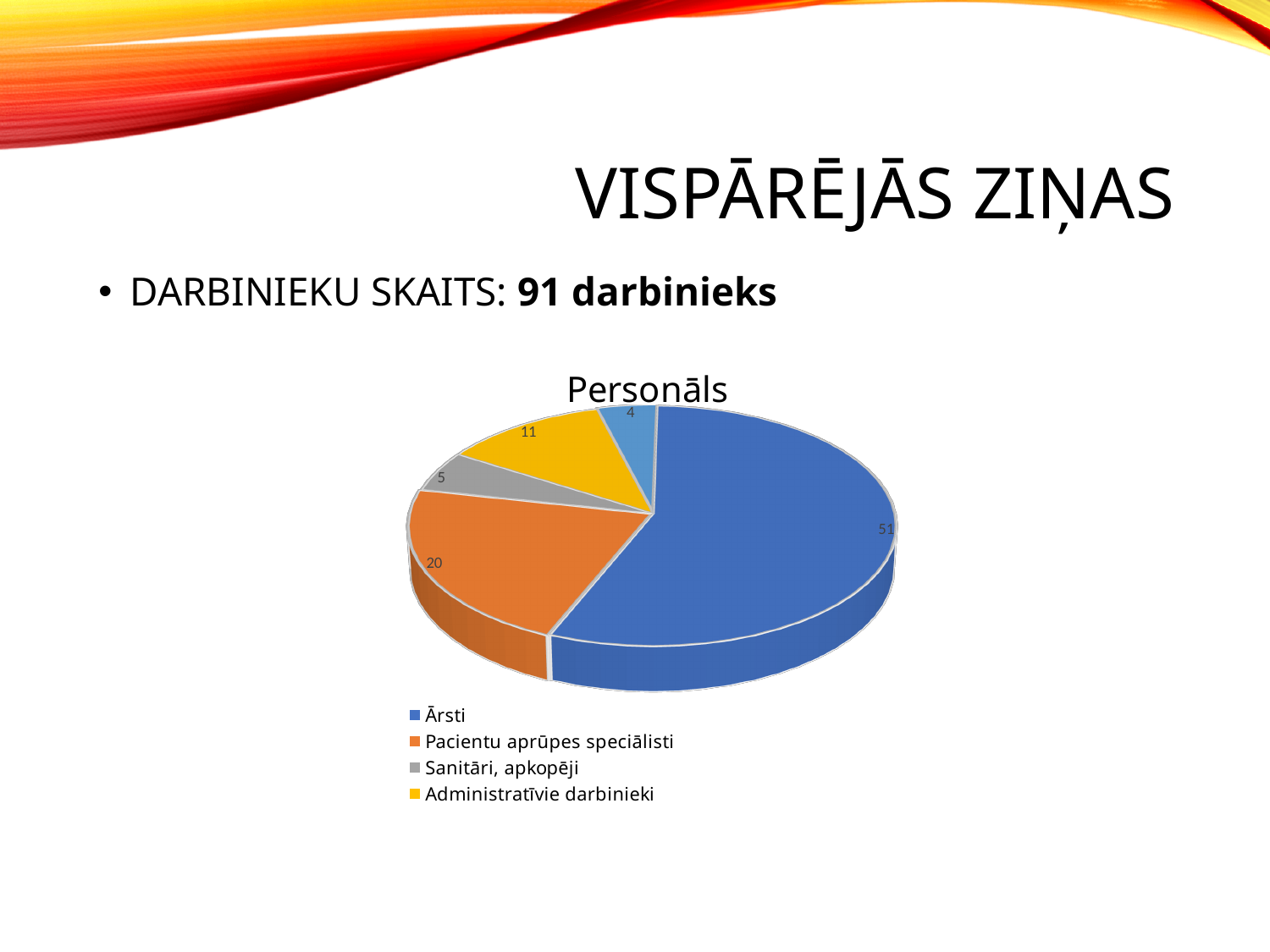
What is the title of the chart on the slide? Personāls How many entries does the legend of the Personāls chart list? 4 In the Personāls pie chart, what is the value for Ārsti? 51 In the Personāls pie chart, which is larger: Administratīvie darbinieki or Sanitāri, apkopēji? Administratīvie darbinieki Which category has the largest slice in the Personāls pie chart? Ārsti How many slices does the Personāls pie chart have? 5 In the Personāls pie chart, what is the difference between the values for Ārsti and Pacientu aprūpes speciālisti? 31 Of the categories listed in the legend of the Personāls pie chart, which has the smallest slice? Sanitāri, apkopēji In the Personāls pie chart, what is the value for Administratīvie darbinieki? 11 In the Personāls pie chart, what is the value for Pacientu aprūpes speciālisti? 20 In the Personāls pie chart, what is the value for Sanitāri, apkopēji? 5 What kind of chart is shown on the slide? Pie chart